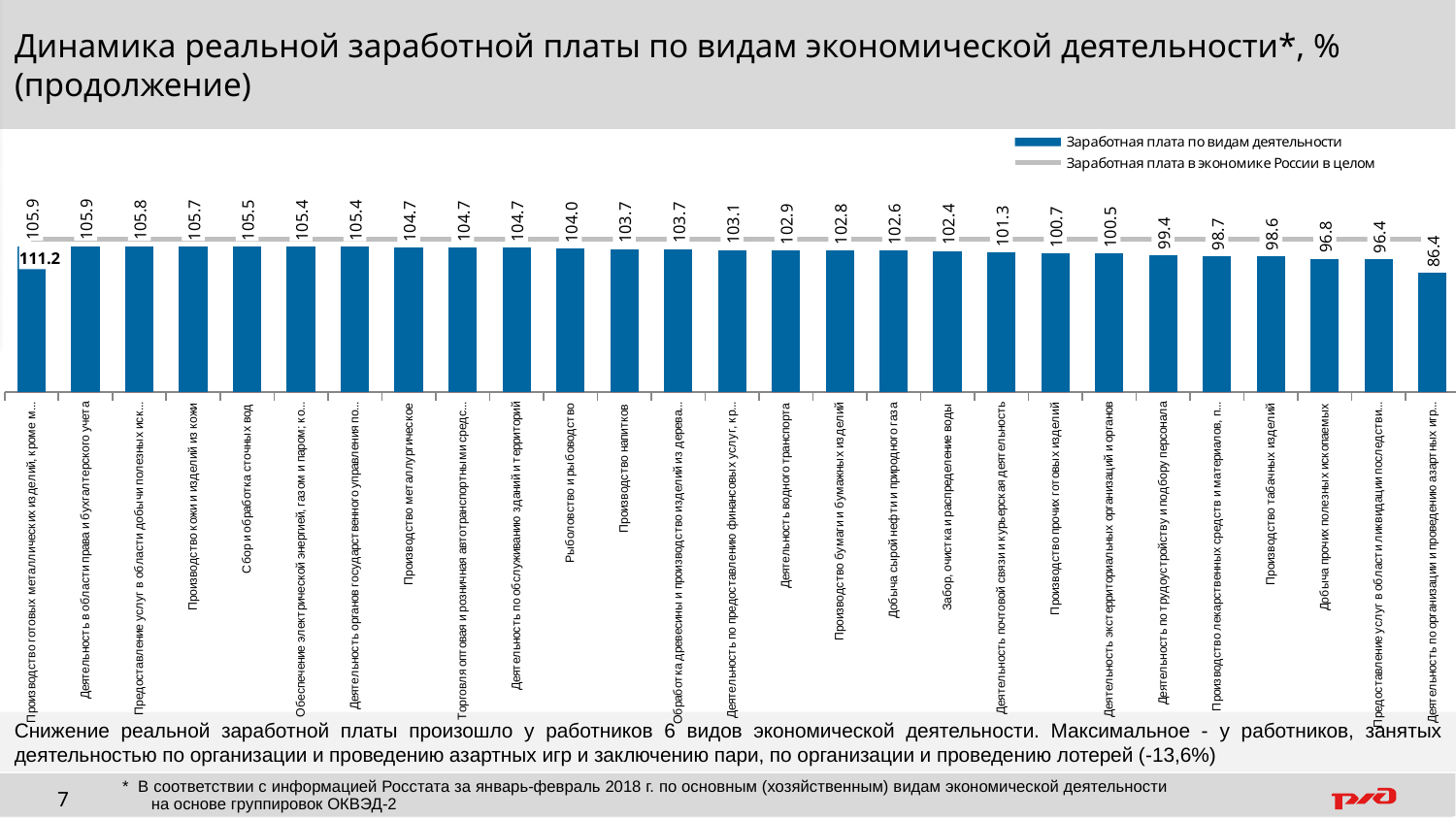
How many categories (types of economic activity) are plotted on the chart? 27 What is the value for 'Добыча сырой нефти и природного газа'? 102.6 What is the value for 'Рыболовство и рыбоводство'? 104.0 What is the value for 'Производство табачных изделий'? 98.6 What type of chart is shown on the slide? Combination bar and line chart Which is larger: the value for 'Производство напитков' or the value for 'Производство табачных изделий'? Производство напитков How many series does the legend list? 2 What is the difference between the value for 'Производство кожи и изделий из кожи' and the value for 'Деятельность по организации и проведению азартных игр...'? 19.1 Do the bar values rise or fall from left to right along the x axis? Fall What value is shown for the grey line 'Заработная плата в экономике России в целом'? 111.2 Which category has the lowest value on the chart? Деятельность по организации и проведению азартных игр... What is the value for 'Деятельность почтовой связи и курьерская деятельность'? 101.3